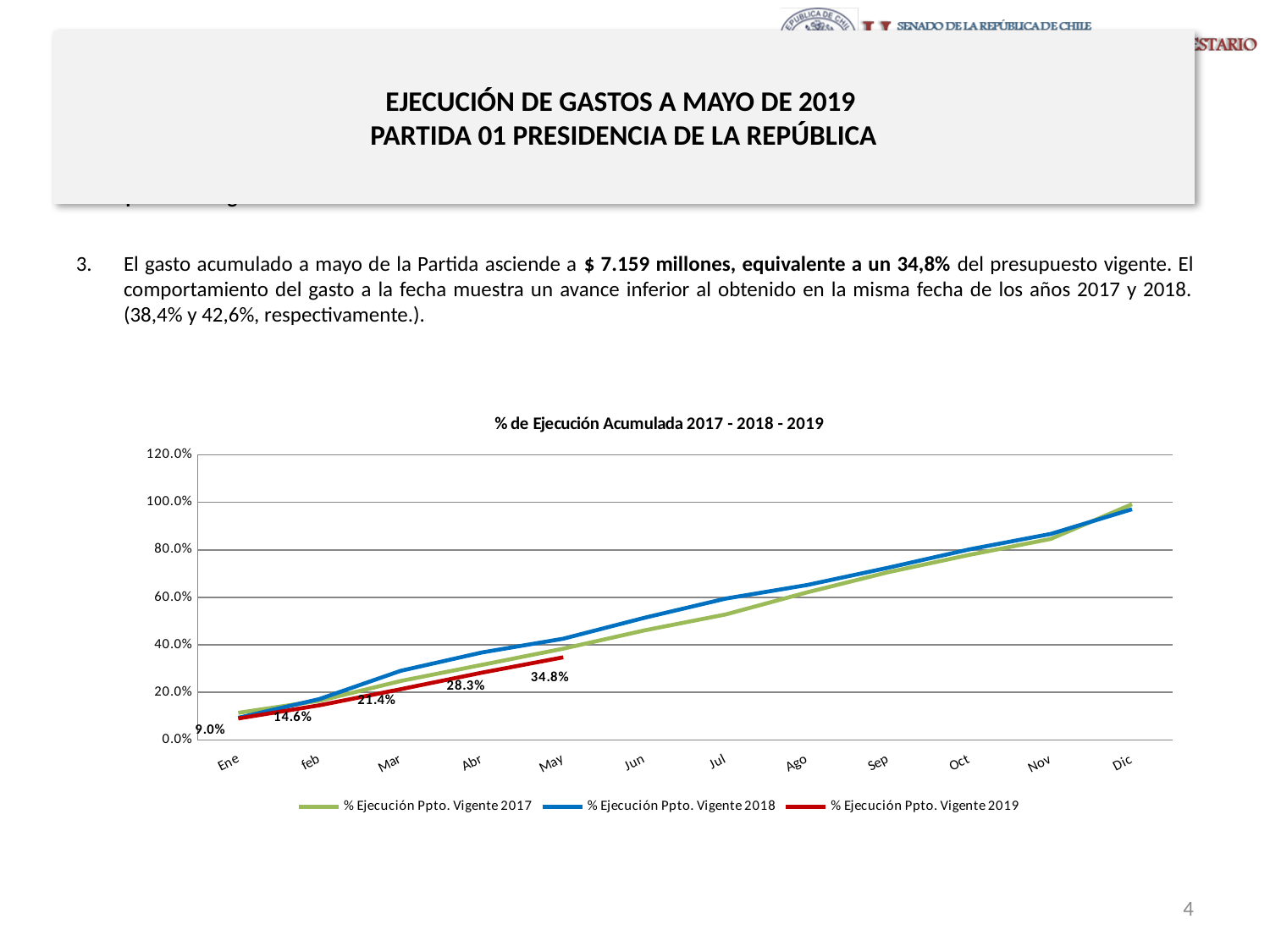
What is the value of % Ejecución Ppto. Vigente 2019 for Ene? 9.0% What is the value of % Ejecución Ppto. Vigente 2019 for May? 34.8% What is the value of % Ejecución Ppto. Vigente 2019 for Mar? 21.4% Does the % Ejecución Ppto. Vigente 2019 series rise or fall from Ene to May? rises How many months are shown on the x axis? 12 How many series does the legend list? 3 Is the value for % Ejecución Ppto. Vigente 2018 in Dic greater or less than 80.0%? greater What kind of chart is shown on the slide? line chart What is the title of the chart? % de Ejecución Acumulada 2017 - 2018 - 2019 What is the difference between the May and Ene values of % Ejecución Ppto. Vigente 2019? 25.8% Which month has the highest value for % Ejecución Ppto. Vigente 2019? May What is the difference between the Abr and Mar values of % Ejecución Ppto. Vigente 2019? 6.9%